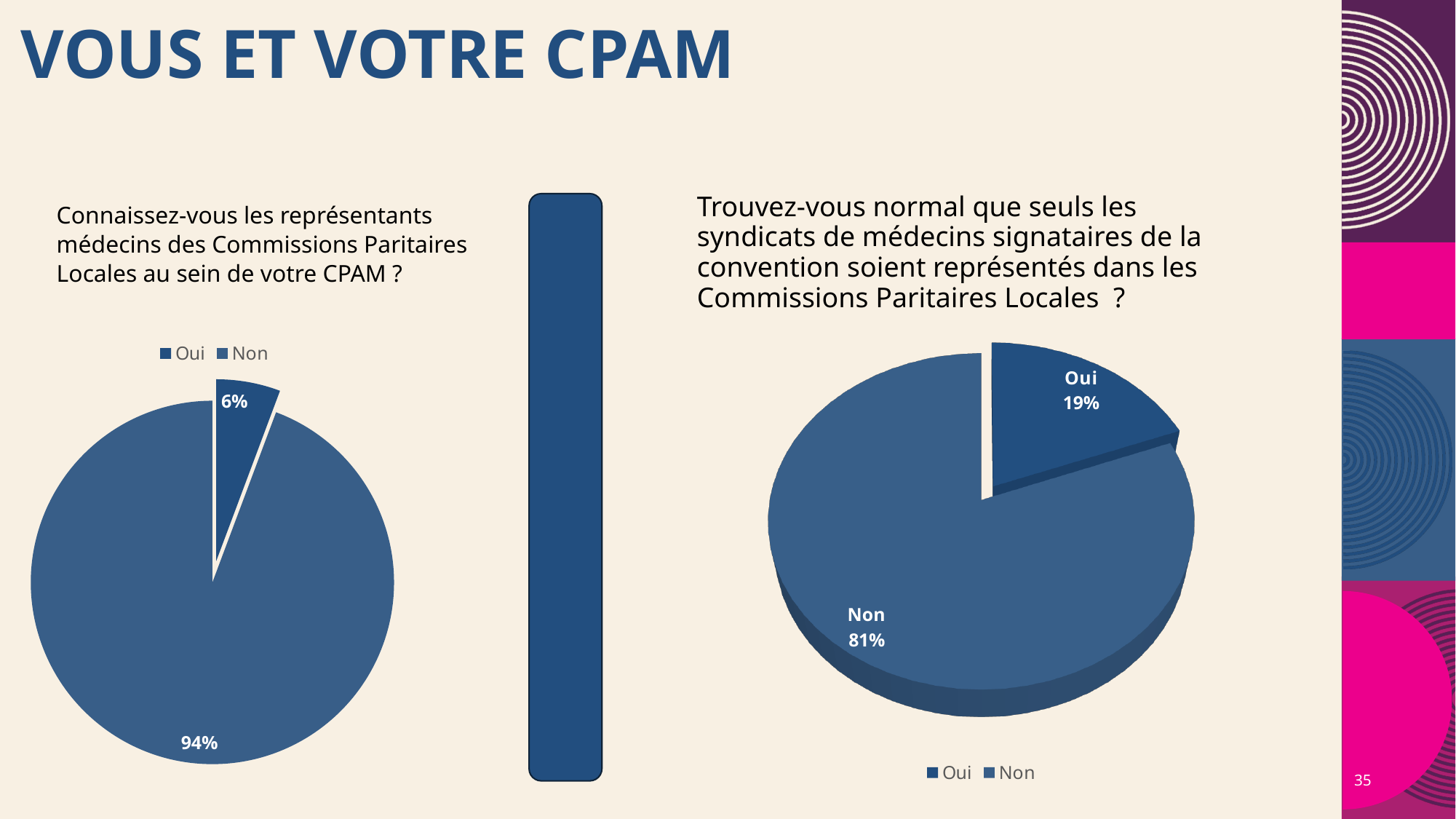
What kind of chart is the chart on the right of the slide? Pie chart In the right pie chart (Trouvez-vous normal que seuls les syndicats...), what share is labelled for Non? 81% How many entries does the legend of the right pie chart list? 2 How many slices does the left pie chart have? 2 In the left pie chart, what is the difference in percentage points between Non and Oui? 88 In the right pie chart, which is larger, Oui or Non? Non In the right pie chart, what is the difference in percentage points between Non and Oui? 62 In the left pie chart (Connaissez-vous les représentants médecins...), what share is labelled for Non? 94% In the right pie chart, which category has the smallest slice? Oui In the left pie chart, which category has the largest slice? Non In the right pie chart (Trouvez-vous normal que seuls les syndicats de médecins signataires...), what share is labelled for Oui? 19% In the left pie chart (Connaissez-vous les représentants médecins des Commissions Paritaires Locales...), what share is labelled for Oui? 6%